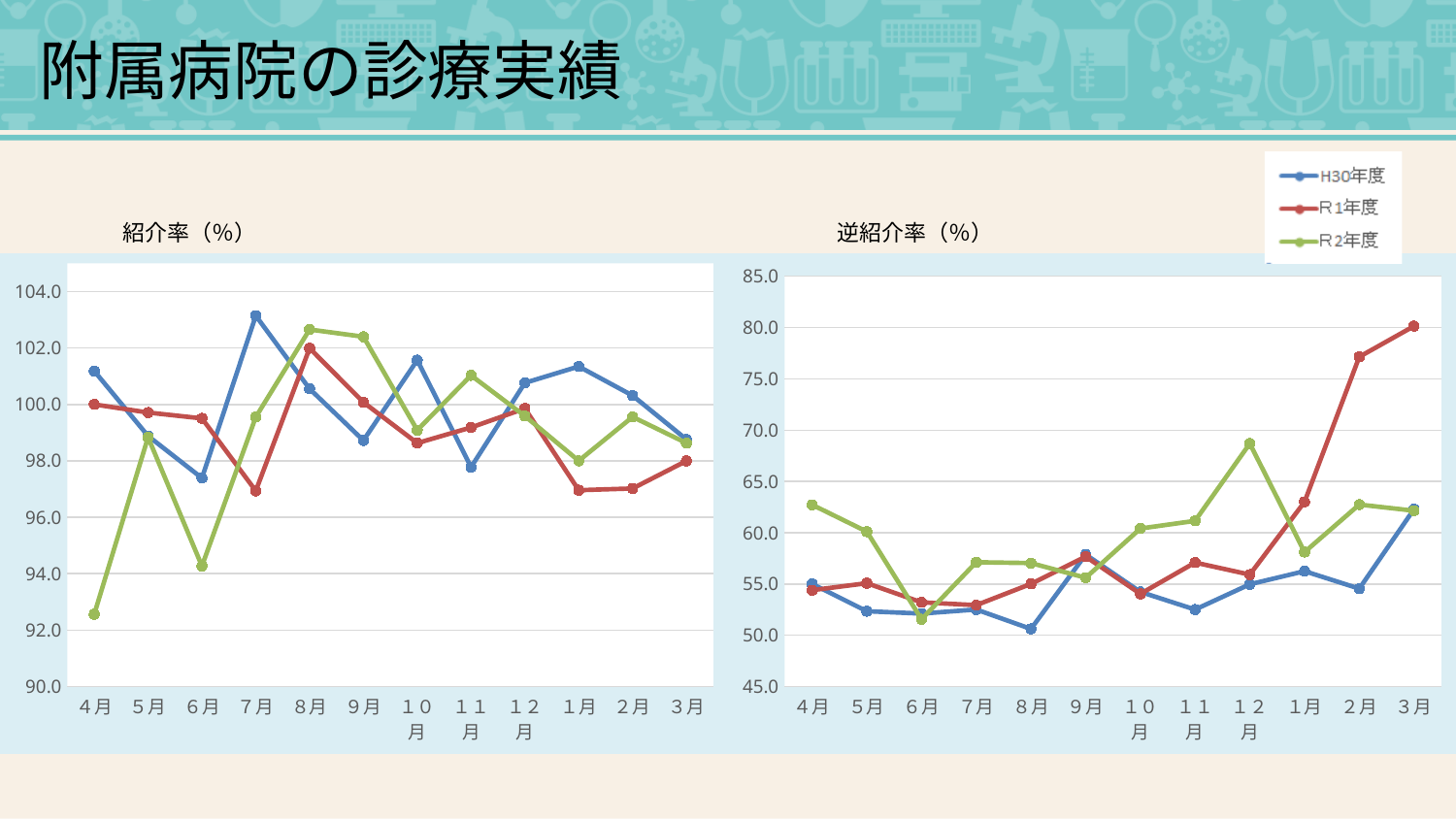
In the 紹介率（%） chart, which month has the lowest R2年度 value? 4月 In the 紹介率（%） chart, is the H30年度 value for 7月 greater or less than 102.0? greater What colour is the R2年度 line in the legend? green In the 逆紹介率（%） chart, which series is higher in 2月, R1年度 or H30年度? R1年度 In the 紹介率（%） chart, is the R2年度 value for 4月 greater or less than 94.0? less In the 逆紹介率（%） chart, does the R1年度 line rise or fall from 12月 to 3月? rise How many months are plotted along the x axis of the 逆紹介率（%） chart? 12 How many series does the legend list? 3 In the 逆紹介率（%） chart, is the H30年度 value for 8月 greater or less than 55.0? less In the 逆紹介率（%） chart, which month has the highest R1年度 value? 3月 What kind of chart is the 紹介率（%） chart on the left? line chart